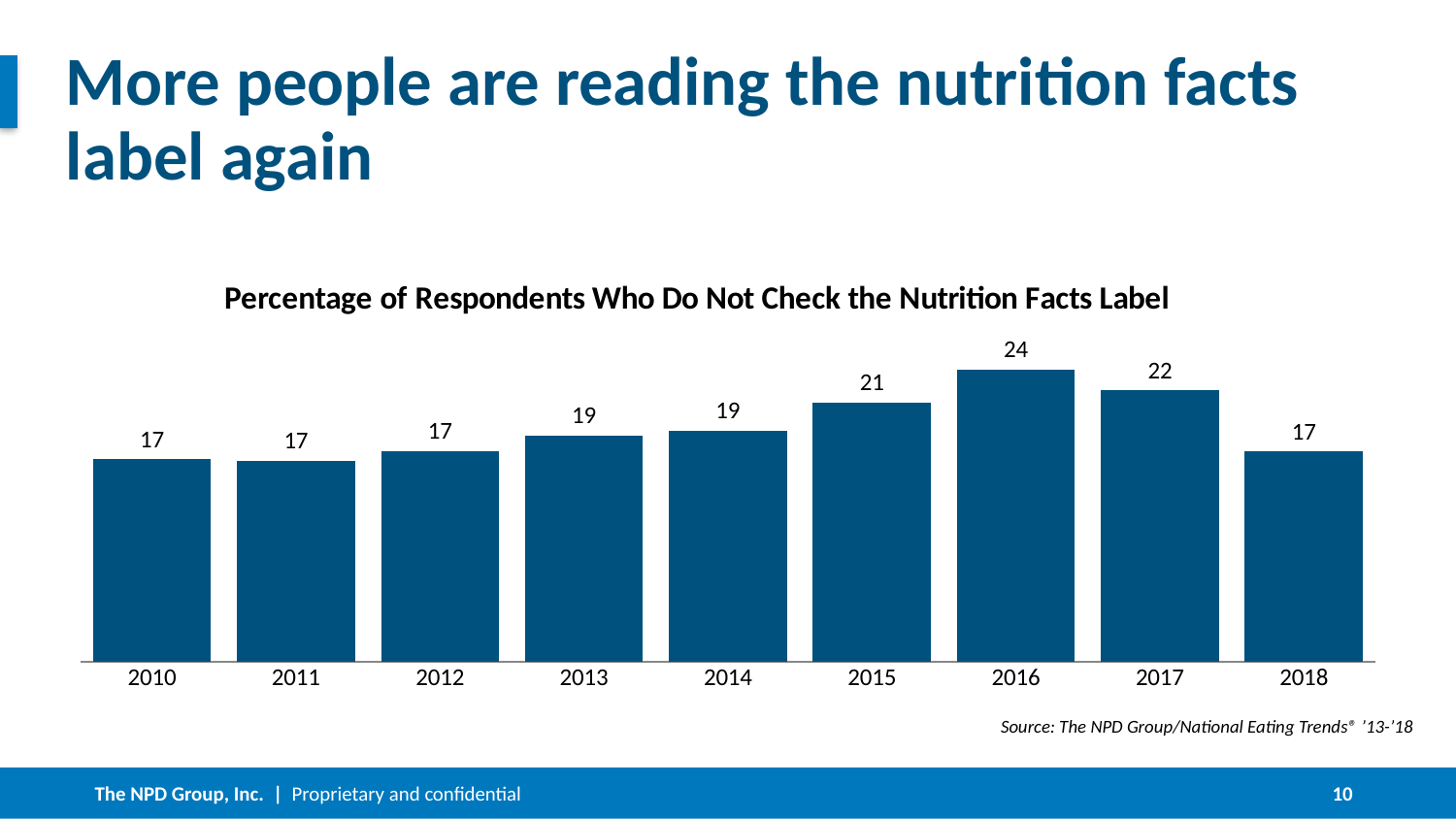
What kind of chart is shown on the slide? Bar chart What is the difference between the values for 2016 and 2018? 7 What is the value for 2016? 24 Which year has the highest value? 2016 Which is larger, the value for 2015 or the value for 2012? 2015 How many years are shown on the x axis? 9 Do the values rise or fall from 2016 to 2018? Fall What is the value for 2018? 17 What is the value for 2013? 19 Do the values rise or fall from 2010 to 2016? Rise What is the difference between the values for 2017 and 2015? 1 What is the title of the chart? Percentage of Respondents Who Do Not Check the Nutrition Facts Label